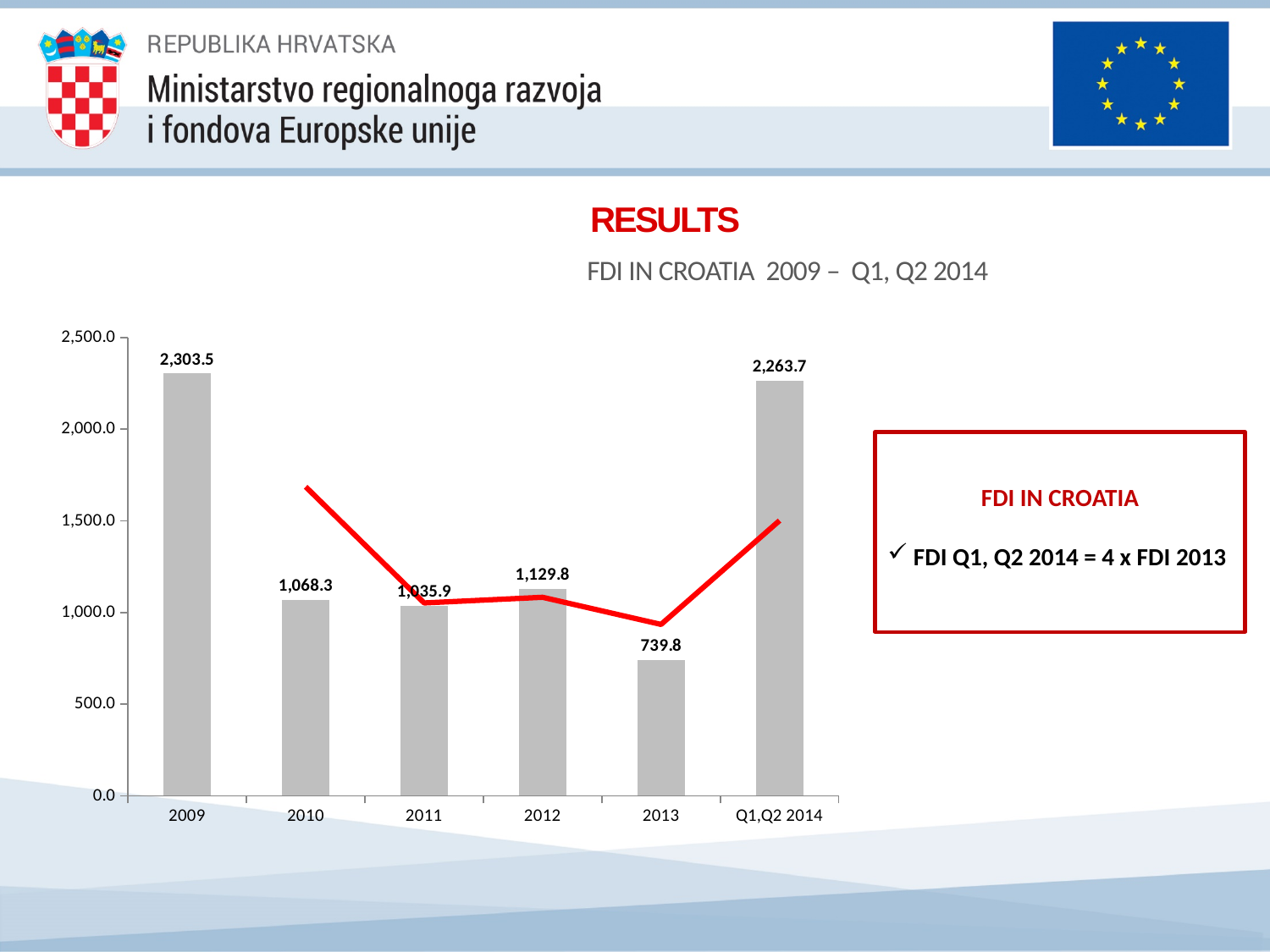
What is the FDI value shown for 2009? 2,303.5 Is the FDI value for 2013 greater or less than 1,000.0? less How many categories are shown on the x axis of the chart? 6 What kind of chart is used to show FDI in Croatia? bar chart Which year has the highest FDI value in the chart? 2009 What is the FDI value shown for Q1,Q2 2014? 2,263.7 Which is larger, the FDI value for 2010 or for 2011? 2010 What is the difference between the FDI values for 2012 and 2013? 390.0 What is the difference between the FDI values for 2009 and Q1,Q2 2014? 39.8 Which year has the lowest FDI value in the chart? 2013 What is the FDI value shown for 2012? 1,129.8 What is the FDI value shown for 2013? 739.8